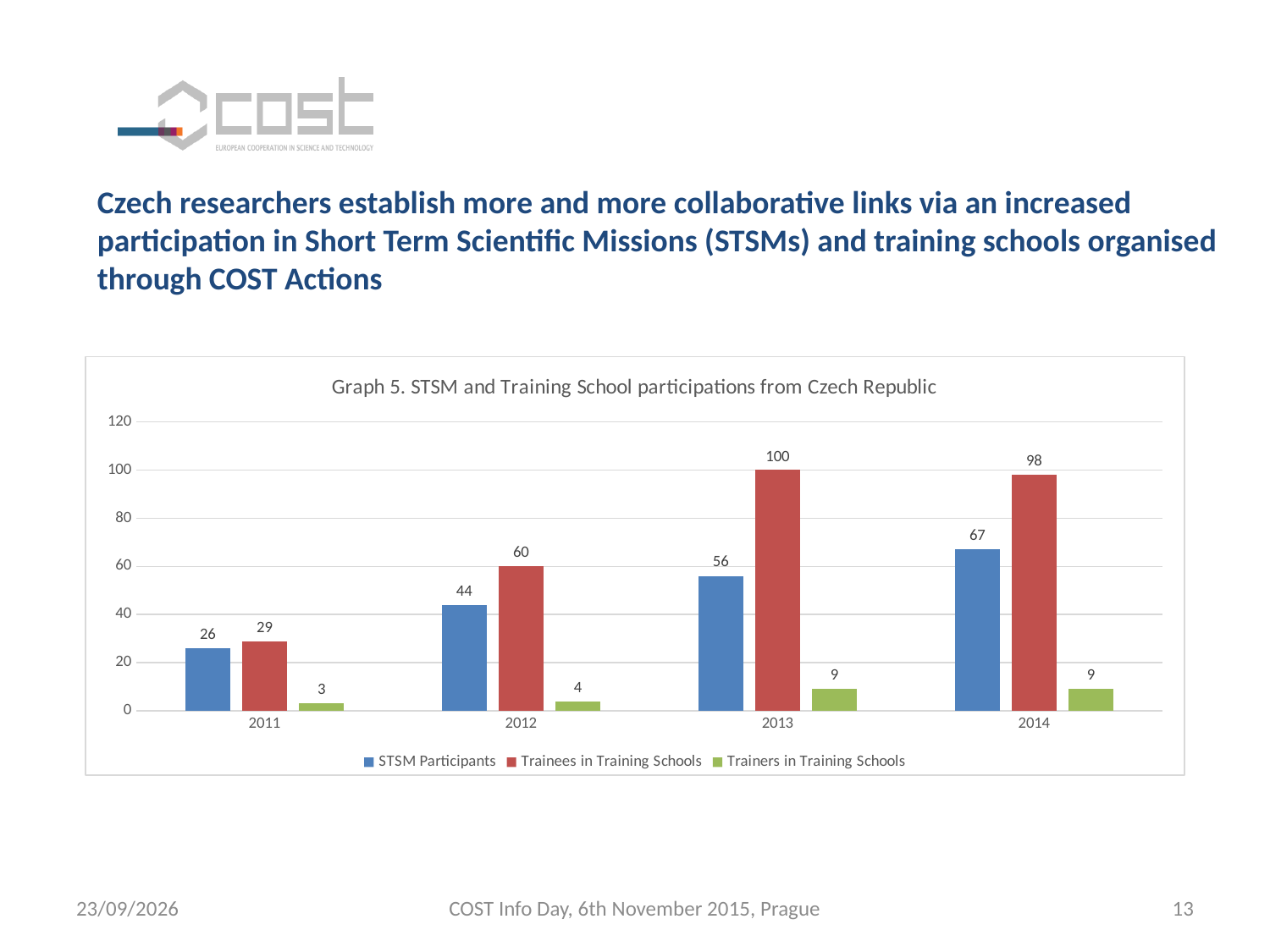
In which year is the number of Trainees in Training Schools highest? 2013 What is the difference between Trainees in Training Schools and STSM Participants in 2013? 44 How many series does the legend list? 3 What kind of chart is shown on the slide? Bar chart In which year is the number of STSM Participants lowest? 2011 What is the number of Trainees in Training Schools in 2014? 98 How many years are shown on the x axis? 4 What is the number of Trainers in Training Schools in 2011? 3 What is the number of STSM Participants in 2012? 44 Is the value for STSM Participants in 2014 greater or less than 60? greater Do the values for Trainees in Training Schools rise or fall from 2011 to 2013? Rise Which is larger in 2012: STSM Participants or Trainees in Training Schools? Trainees in Training Schools